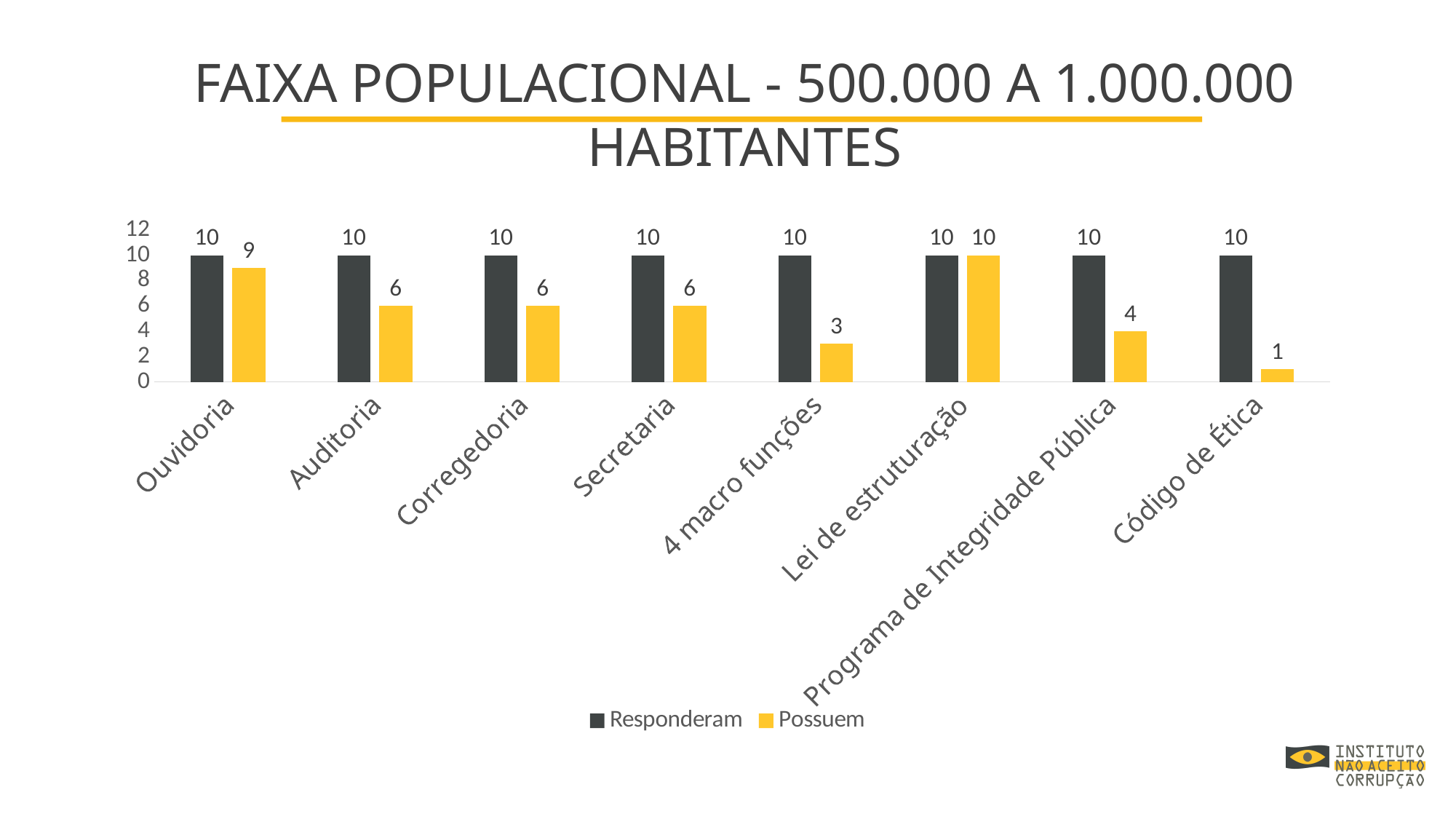
What is the 'Possuem' value for Programa de Integridade Pública? 4 Which category has the highest 'Possuem' value? Lei de estruturação Which category has the lowest 'Possuem' value? Código de Ética How many series does the legend list? 2 Which is larger, the 'Possuem' value for Auditoria or for Programa de Integridade Pública? Auditoria What is the 'Responderam' value for Código de Ética? 10 What is the 'Possuem' value for 4 macro funções? 3 What kind of chart is shown on the slide? Bar chart What is the 'Possuem' value for Ouvidoria? 9 How many categories are shown on the x axis? 8 What is the difference between the 'Responderam' and 'Possuem' values for Secretaria? 4 Which series is shown in yellow? Possuem